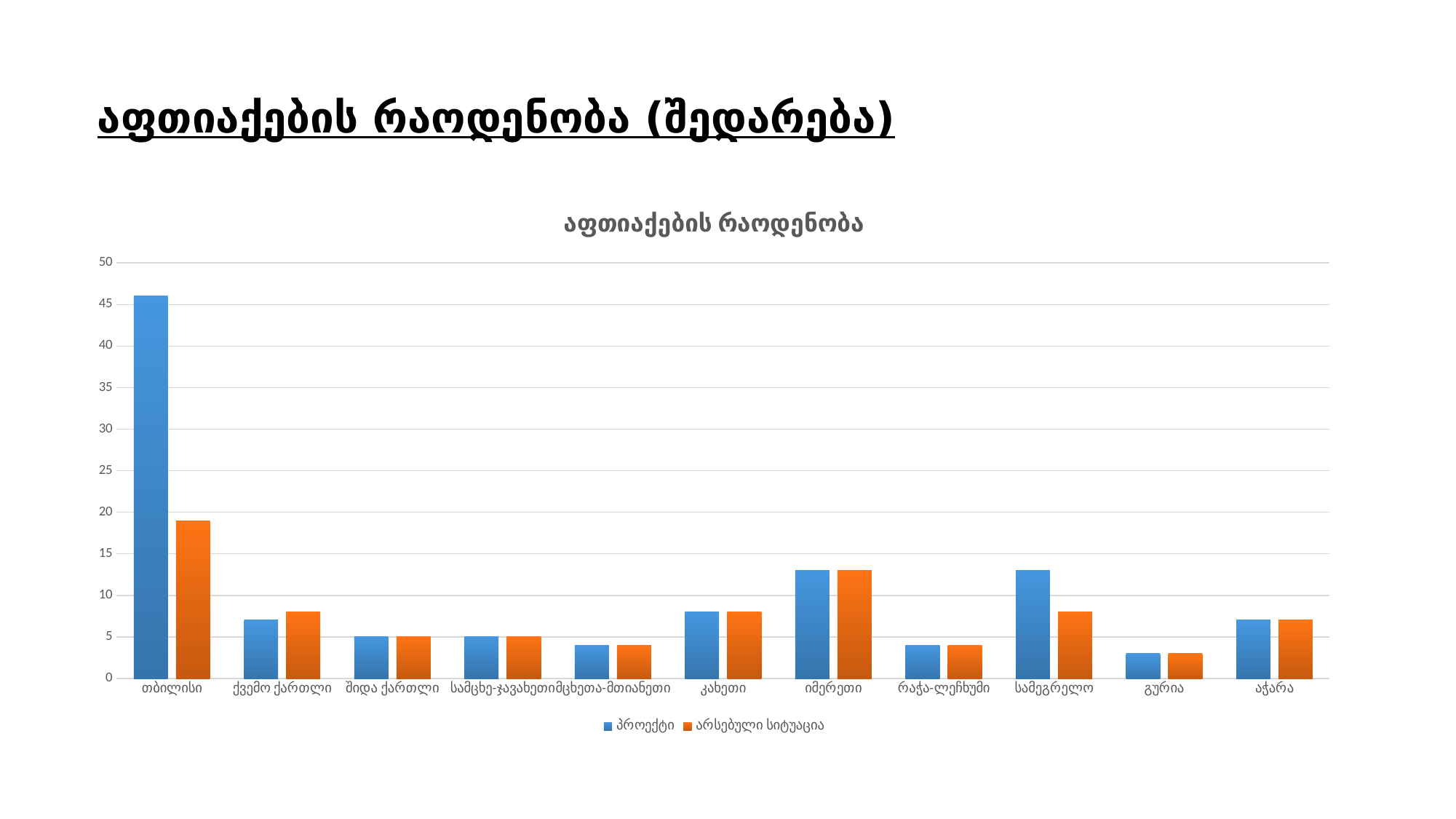
For სამეგრელო, which is larger: პროექტი or არსებული სიტუაცია? პროექტი How many categories are shown on the x axis? 11 What kind of chart is shown on the slide? bar chart How many series does the legend list? 2 Is the პროექტი value for თბილისი greater or less than 40? greater Which colour represents the პროექტი series? blue What is the title of the chart? აფთიაქების რაოდენობა Which category has the highest value for პროექტი? თბილისი What is the პროექტი value for შიდა ქართლი? 5 Which category has the highest value for არსებული სიტუაცია? თბილისი What is the არსებული სიტუაცია value for სამცხე-ჯავახეთი? 5 Is the პროექტი value for იმერეთი greater or less than 10? greater